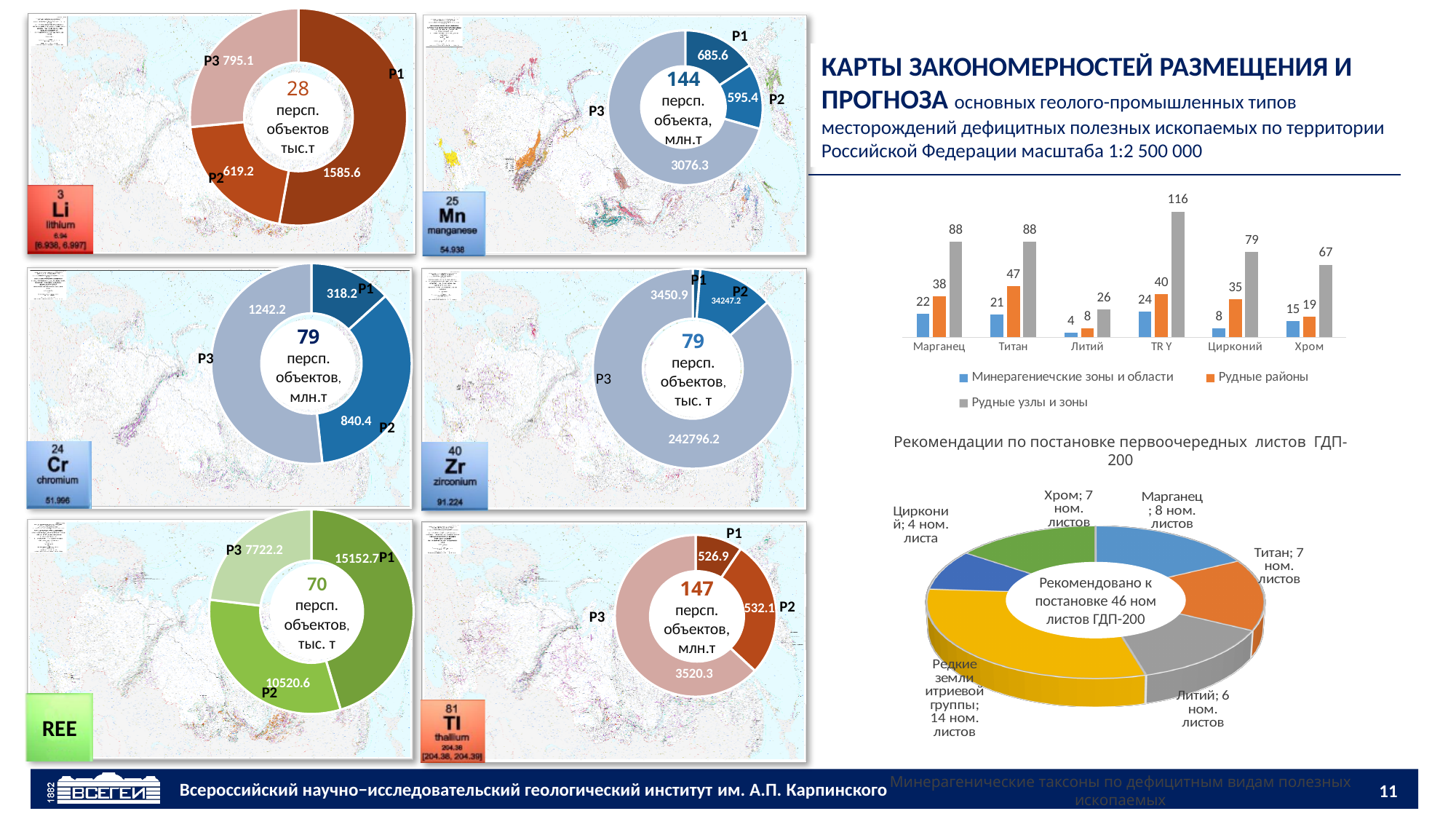
In the pie chart titled 'Рекомендации по постановке первоочередных листов ГДП-200', how many sheets are recommended for Литий? 6 ном. листов In the bar chart on the right, what is the difference between 'Рудные районы' for Титан and for Марганец? 9 In the bar chart on the right, which category has the highest value for 'Рудные узлы и зоны'? TR Y In the pie chart titled 'Рекомендации по постановке первоочередных листов ГДП-200', which category has the largest number of sheets? Редкие земли итриевой группы In the Mn donut chart, which segment is larger, P1 or P2? P1 In the bar chart on the right, what is the value of 'Рудные узлы и зоны' for TR Y? 116 In the Li donut chart (top left), what is the value for P1? 1585.6 In the bar chart on the right, how many series does the legend list? 3 In the bar chart on the right, which category has the lowest value for 'Минерагениечские зоны и области'? Литий In the bar chart on the right, how many categories are shown on the x axis? 6 In the Tl donut chart (bottom, second column), how many prospective objects are stated in the centre? 147 In the Zr donut chart, what is the value for P3? 242796.2